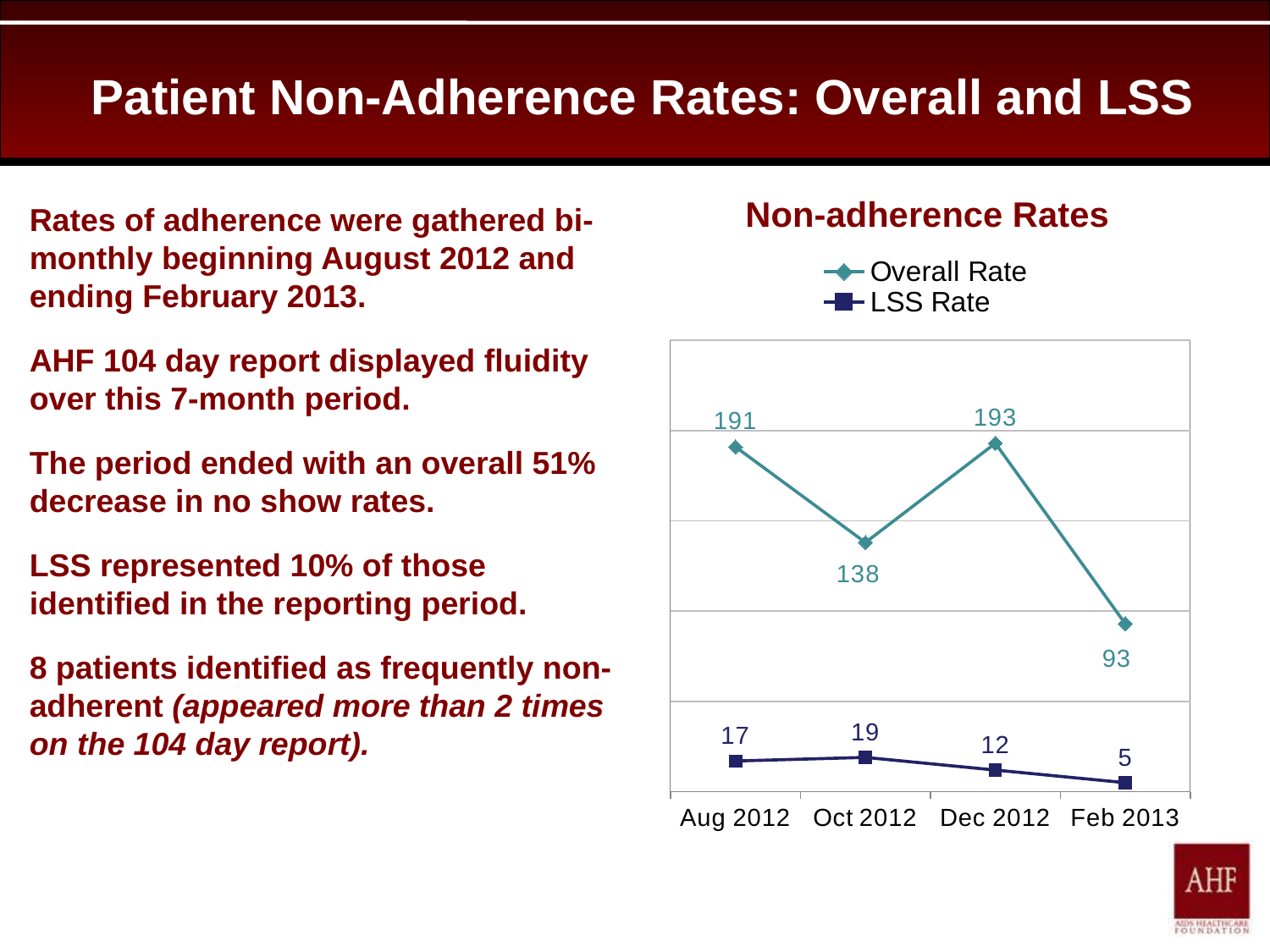
How many time points are plotted on the x axis? 4 What is the Overall Rate for Aug 2012? 191 In which month is the Overall Rate highest? Dec 2012 In which month is the LSS Rate lowest? Feb 2013 What is the difference between the Overall Rate in Dec 2012 and Feb 2013? 100 Which is larger, the LSS Rate in Aug 2012 or in Oct 2012? Oct 2012 What is the LSS Rate for Feb 2013? 5 What kind of chart is shown? Line chart Does the LSS Rate rise or fall from Oct 2012 to Feb 2013? Fall What is the title of the chart? Non-adherence Rates How many series does the legend list? 2 What is the Overall Rate for Oct 2012? 138